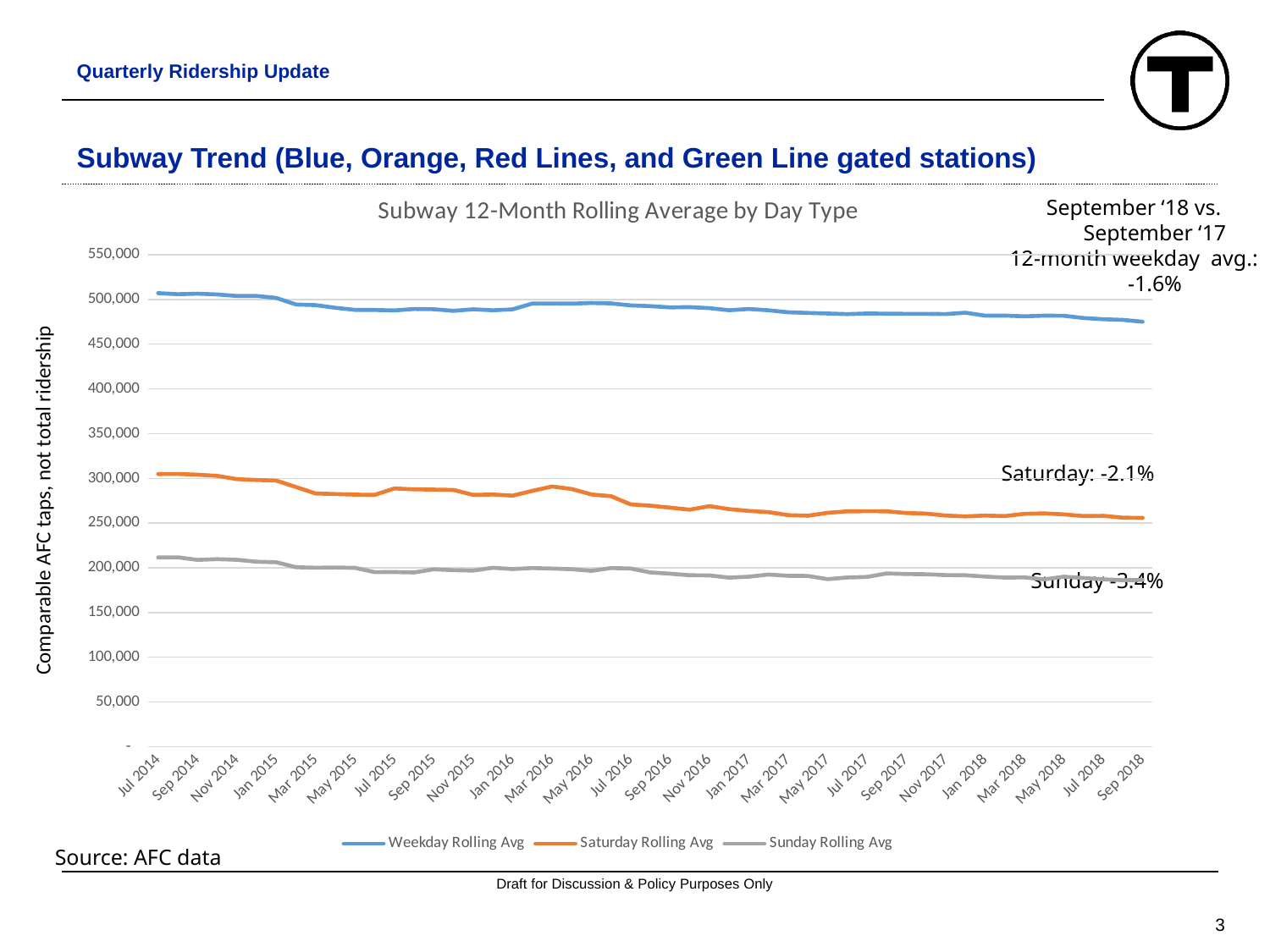
According to the annotation, what is the September '18 vs. September '17 change in the 12-month weekday average? -1.6% Which series has the lowest values throughout the chart? Sunday Rolling Avg Is the Sunday Rolling Avg value for Sep 2018 greater or less than 200,000? less How many series does the legend list? 3 Is the Weekday Rolling Avg value for Jul 2014 greater or less than 500,000? greater Does the Weekday Rolling Avg rise or fall from Jul 2014 to Sep 2018? Fall Is the Saturday Rolling Avg value for Sep 2018 greater or less than 300,000? less What is the title of the chart? Subway 12-Month Rolling Average by Day Type What is the label on the vertical axis? Comparable AFC taps, not total ridership Which series has the highest values throughout the chart? Weekday Rolling Avg Which is larger in Sep 2018, the Saturday Rolling Avg or the Sunday Rolling Avg? Saturday Rolling Avg What kind of chart is shown on the slide? Line chart